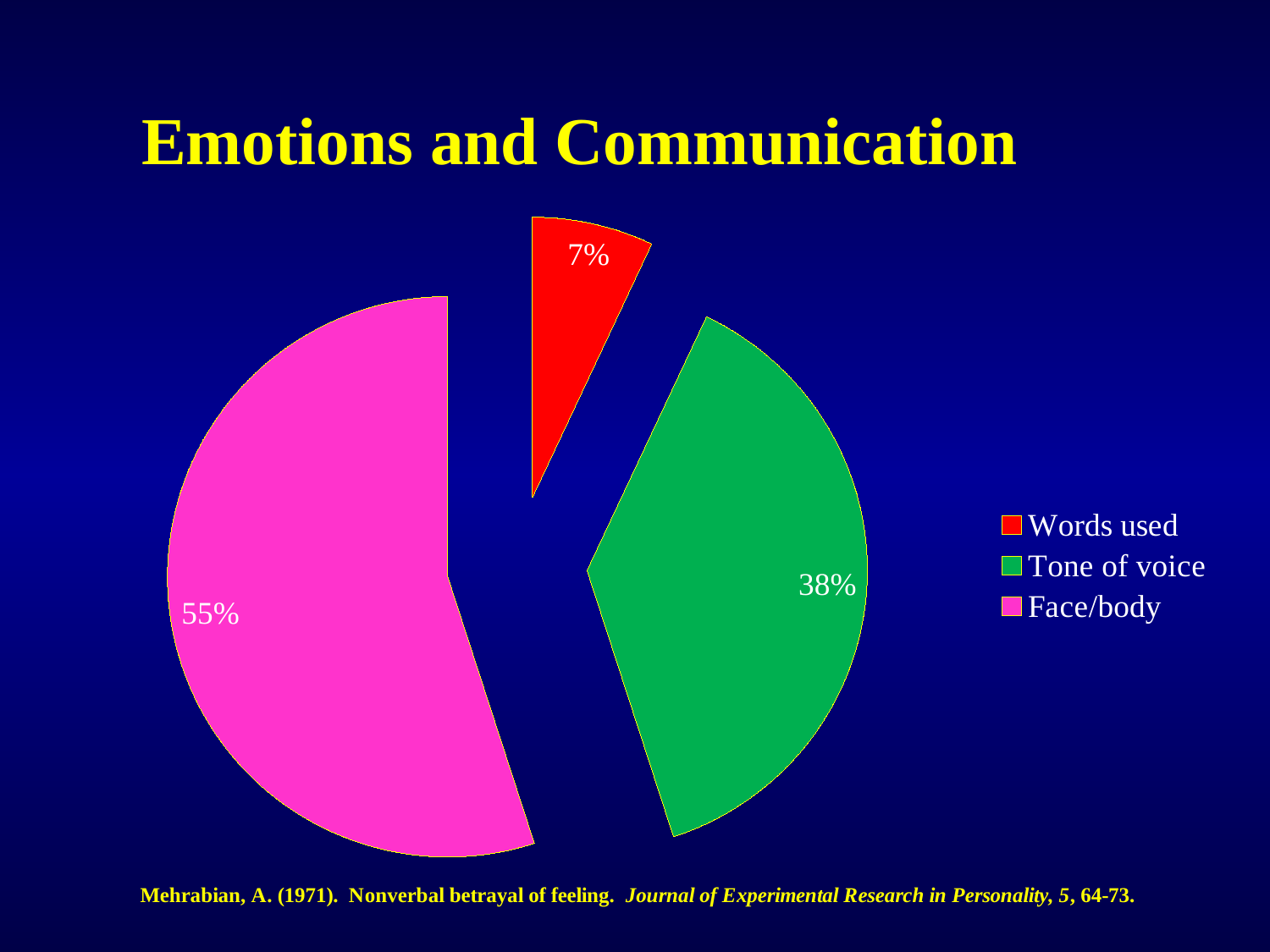
What kind of chart is shown on the slide? pie chart How many slices does the pie chart have? 3 What share of the pie is Words used? 7% Which category has the largest slice? Face/body What share of the pie is Tone of voice? 38% What is the title of the slide containing the chart? Emotions and Communication What colour is the Face/body slice? pink What is the difference between the Face/body share and the Tone of voice share? 17% Which is larger, Tone of voice or Words used? Tone of voice What is the difference between the Tone of voice share and the Words used share? 31% What share of the pie is Face/body? 55% Which category has the smallest slice? Words used